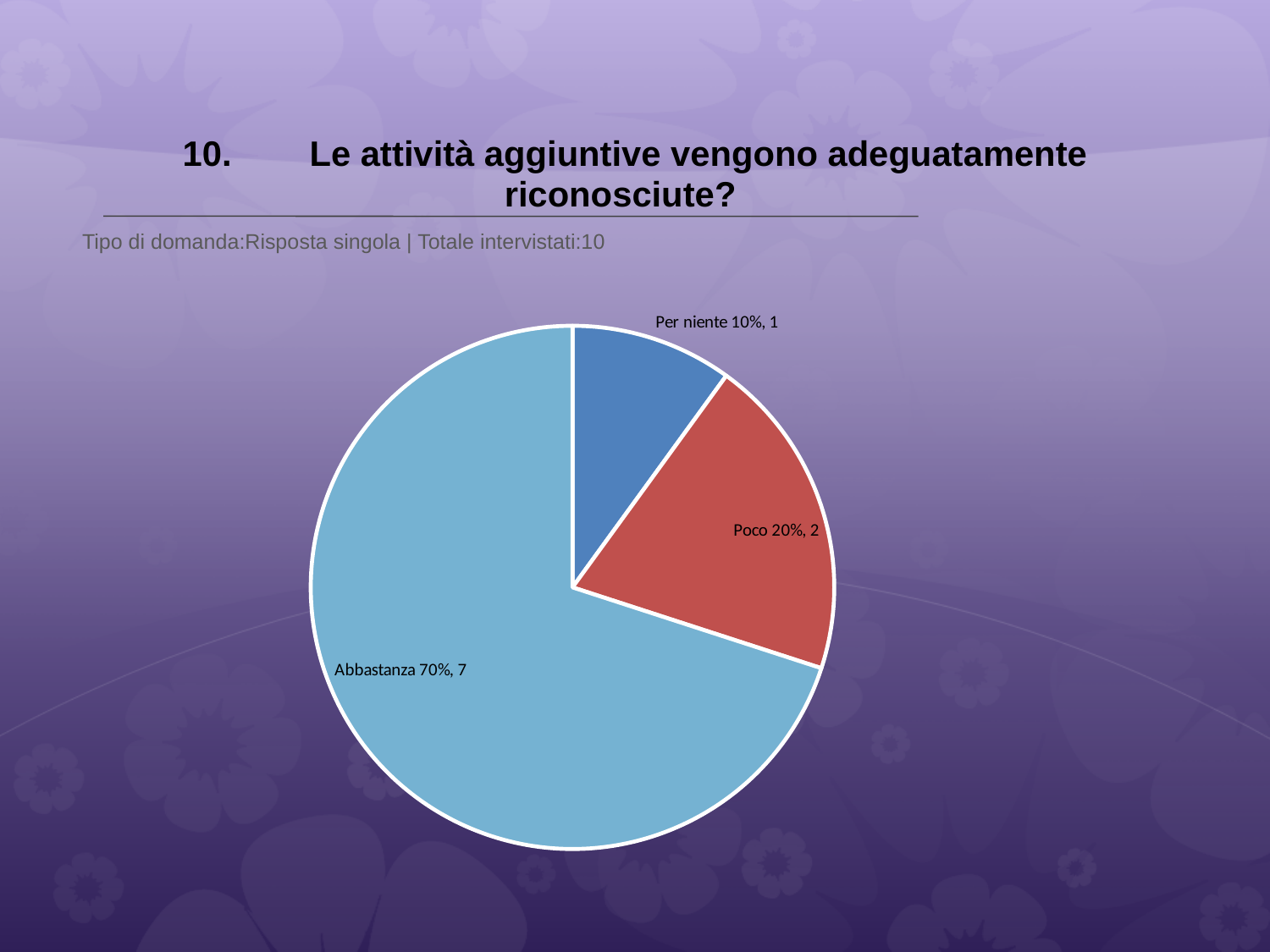
Which category has the smallest slice of the pie? Per niente What share of the pie does the 'Poco' slice represent? 20% How many respondents answered 'Per niente'? 1 What is the difference in number of respondents between 'Abbastanza' and 'Poco'? 5 How many respondents answered 'Poco'? 2 What share of the pie does the 'Per niente' slice represent? 10% Which slice is larger, 'Poco' or 'Per niente'? Poco What kind of chart is shown on the slide? pie chart How many slices does the pie chart have? 3 How many respondents answered 'Abbastanza'? 7 Which category has the largest slice of the pie? Abbastanza What share of the pie does the 'Abbastanza' slice represent? 70%